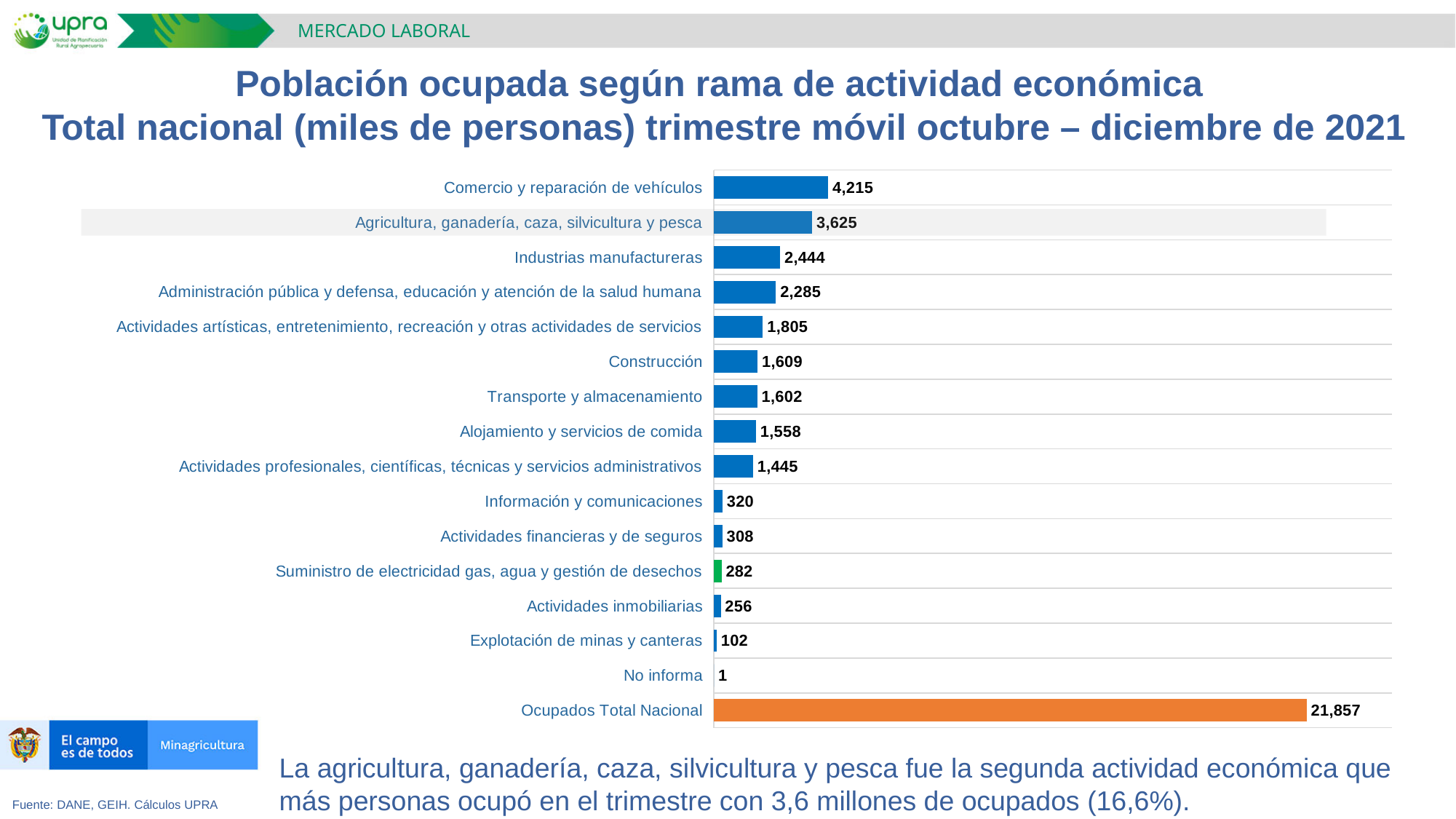
What is the difference between Información y comunicaciones and Actividades financieras y de seguros? 12 What is the difference between Comercio y reparación de vehículos and Agricultura, ganadería, caza, silvicultura y pesca? 590 Which category has the lowest value? No informa What is the value for Agricultura, ganadería, caza, silvicultura y pesca? 3,625 What colour is the bar for Suministro de electricidad gas, agua y gestión de desechos? Green What is the value for Comercio y reparación de vehículos? 4,215 What is the value for Explotación de minas y canteras? 102 How many bars are shown in the chart? 16 What is the value for Ocupados Total Nacional? 21,857 What kind of chart is shown on the slide? Bar chart Excluding Ocupados Total Nacional, which economic activity has the highest value? Comercio y reparación de vehículos Which is larger, Industrias manufactureras or Alojamiento y servicios de comida? Industrias manufactureras